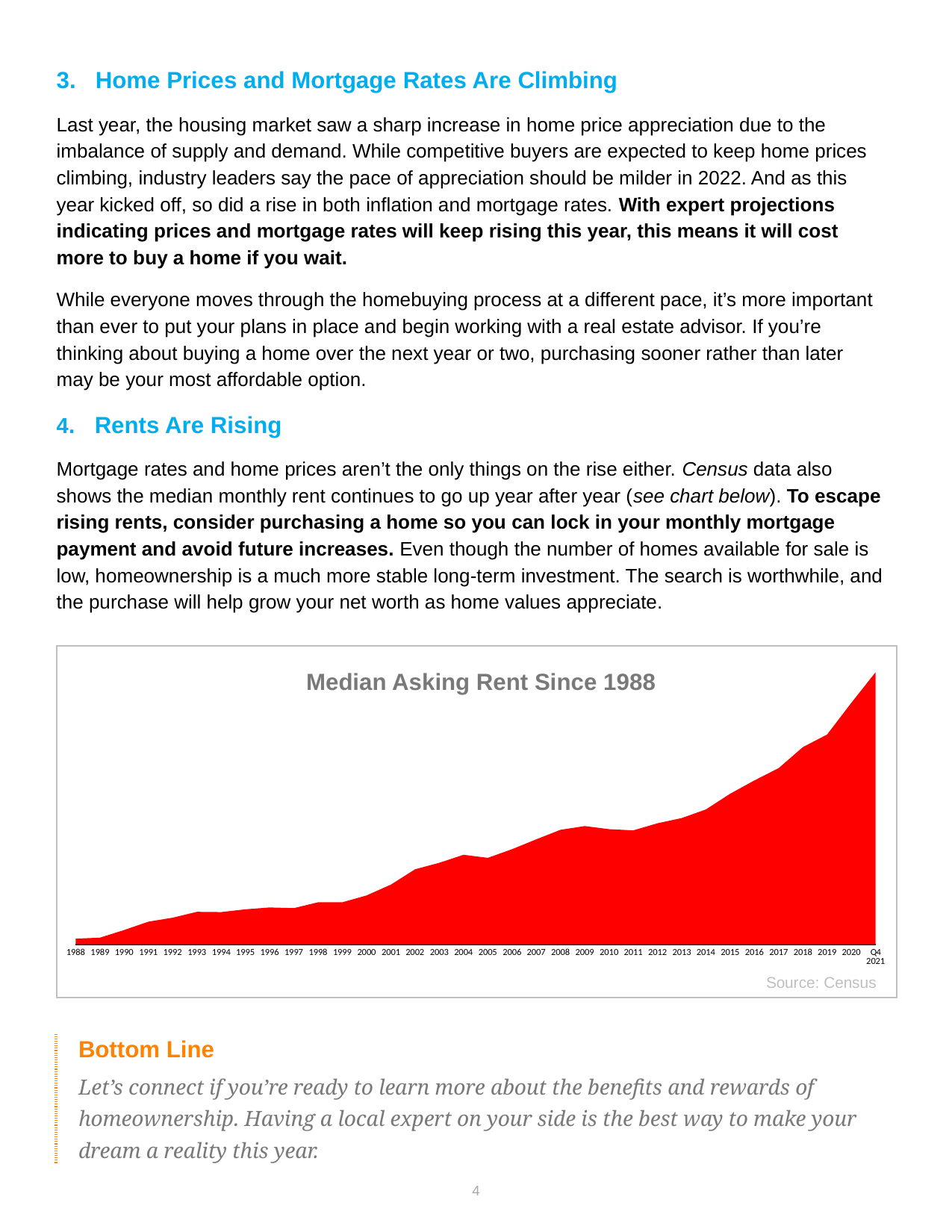
What is the first year shown on the x axis of the chart? 1988 What is the last point shown on the x axis of the chart? Q4 2021 What is the title of the chart on the slide? Median Asking Rent Since 1988 Is the median asking rent higher in 2020 or in 2000? 2020 Do the values in the Median Asking Rent chart generally rise or fall from 1988 to Q4 2021? Rise Is the median asking rent higher in 1995 or in 2015? 2015 How many points are labeled along the x axis of the Median Asking Rent chart? 34 What source is cited for the Median Asking Rent chart? Census Which point on the x axis has the highest median asking rent in the chart? Q4 2021 Which year has the lowest median asking rent in the chart? 1988 What kind of chart is shown on the slide? Area chart